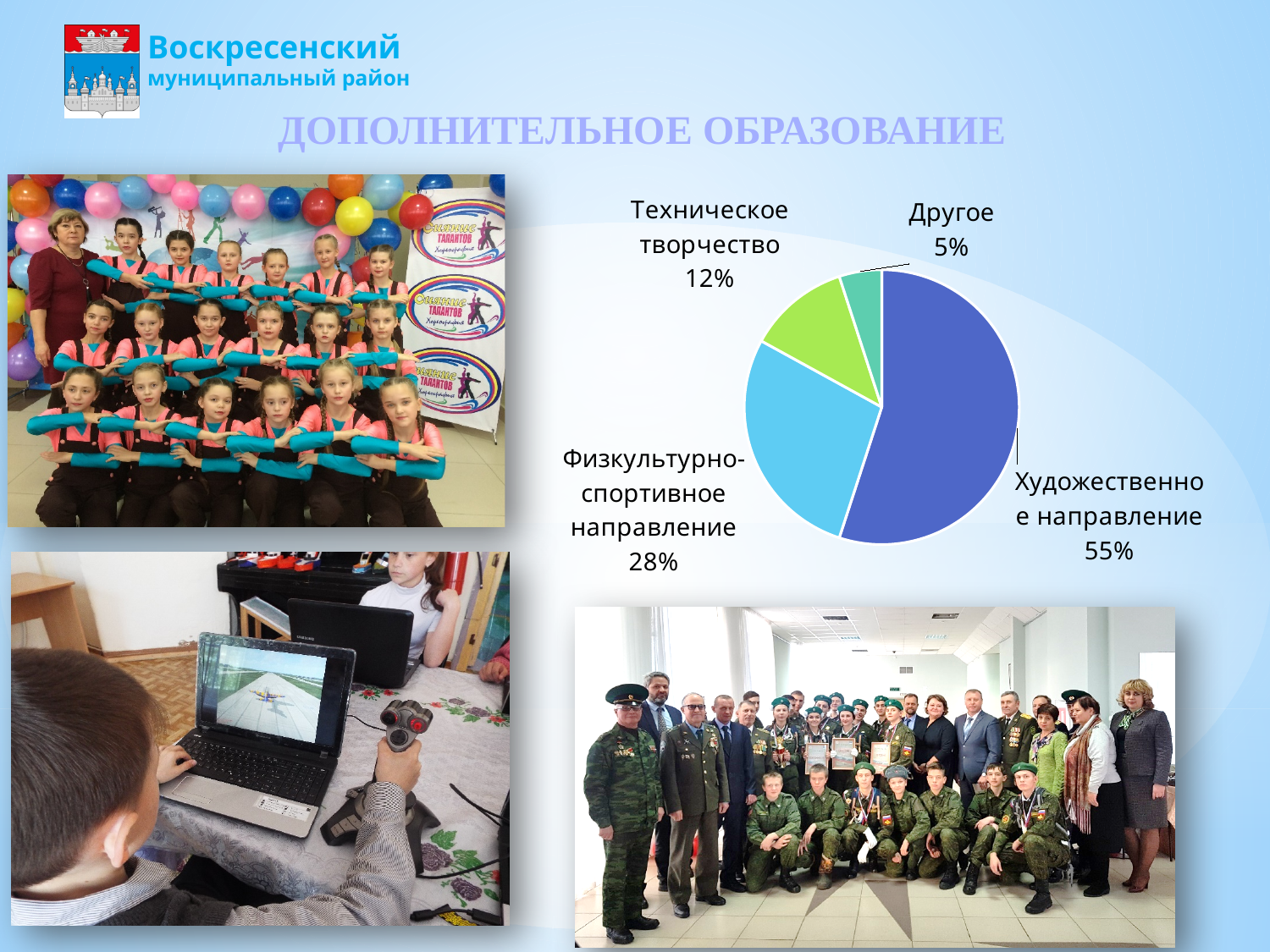
What kind of chart is shown on the slide? pie chart What is the value for Физкультурно-спортивное направление? 28% What is the title shown above the chart on the slide? ДОПОЛНИТЕЛЬНОЕ ОБРАЗОВАНИЕ Which category has the smallest slice of the pie? Другое What is the value for Техническое творчество? 12% Which is larger, Техническое творчество or Другое? Техническое творчество What is the difference between Техническое творчество and Другое? 7% What is the value for Другое? 5% What share of the pie does Художественное направление have? 55% How many slices does the pie chart have? 4 What is the difference between Художественное направление and Физкультурно-спортивное направление? 27% Which category has the largest slice of the pie? Художественное направление